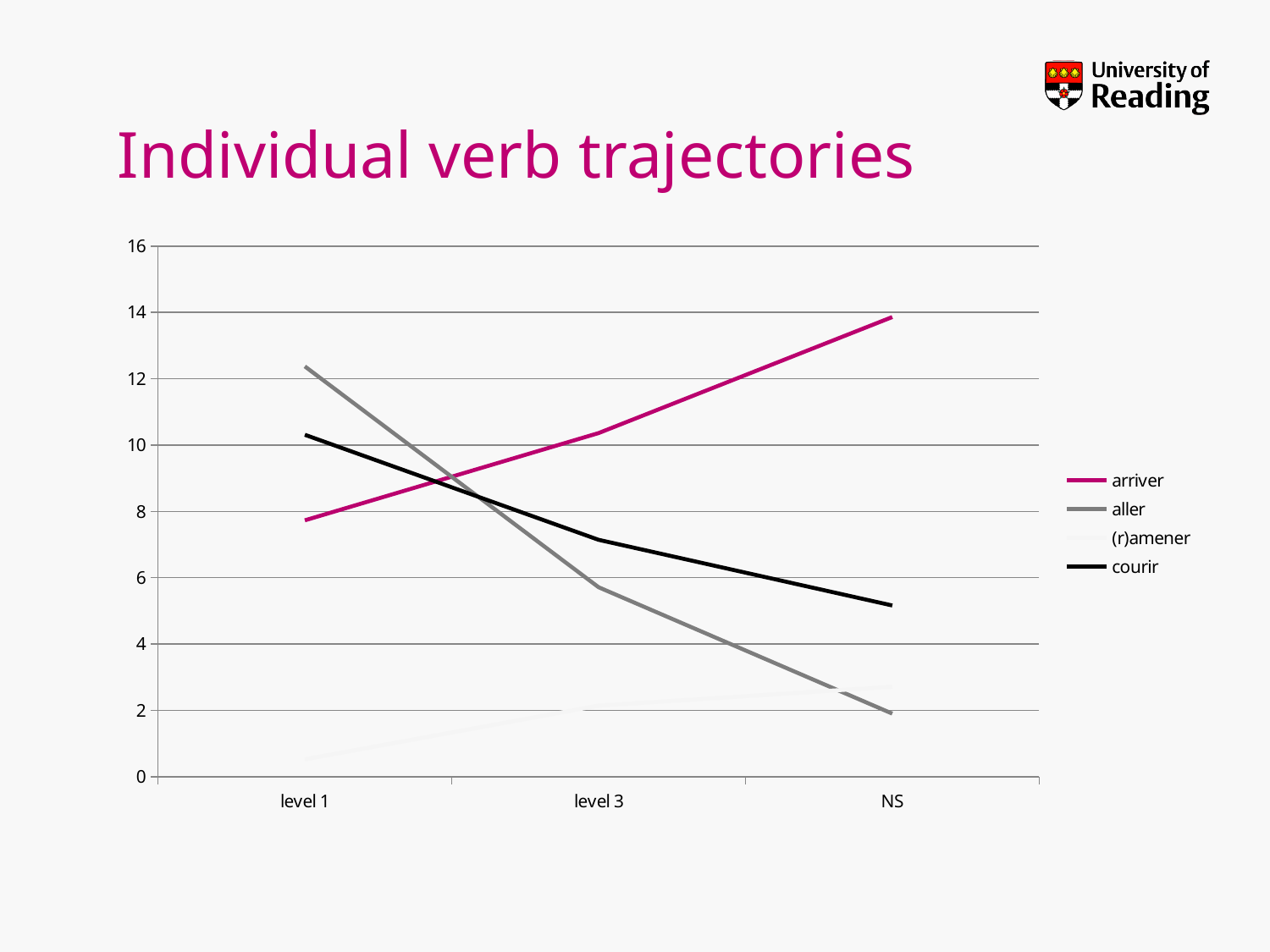
How many categories are shown along the x axis? 3 Does the value for courir rise or fall from level 1 to NS? fall How many series does the legend list? 4 Is the value for aller at NS greater or less than 4? less What is the title of the slide? Individual verb trajectories Is the value for courir at level 1 greater or less than 8? greater Which series has the highest value at NS? arriver What kind of chart is shown on the slide? line chart At level 1, which is larger, the value for aller or the value for arriver? aller Is the value for arriver at NS greater or less than 12? greater Does the value for arriver rise or fall from level 1 to NS? rise Does the value for aller rise or fall from level 1 to NS? fall